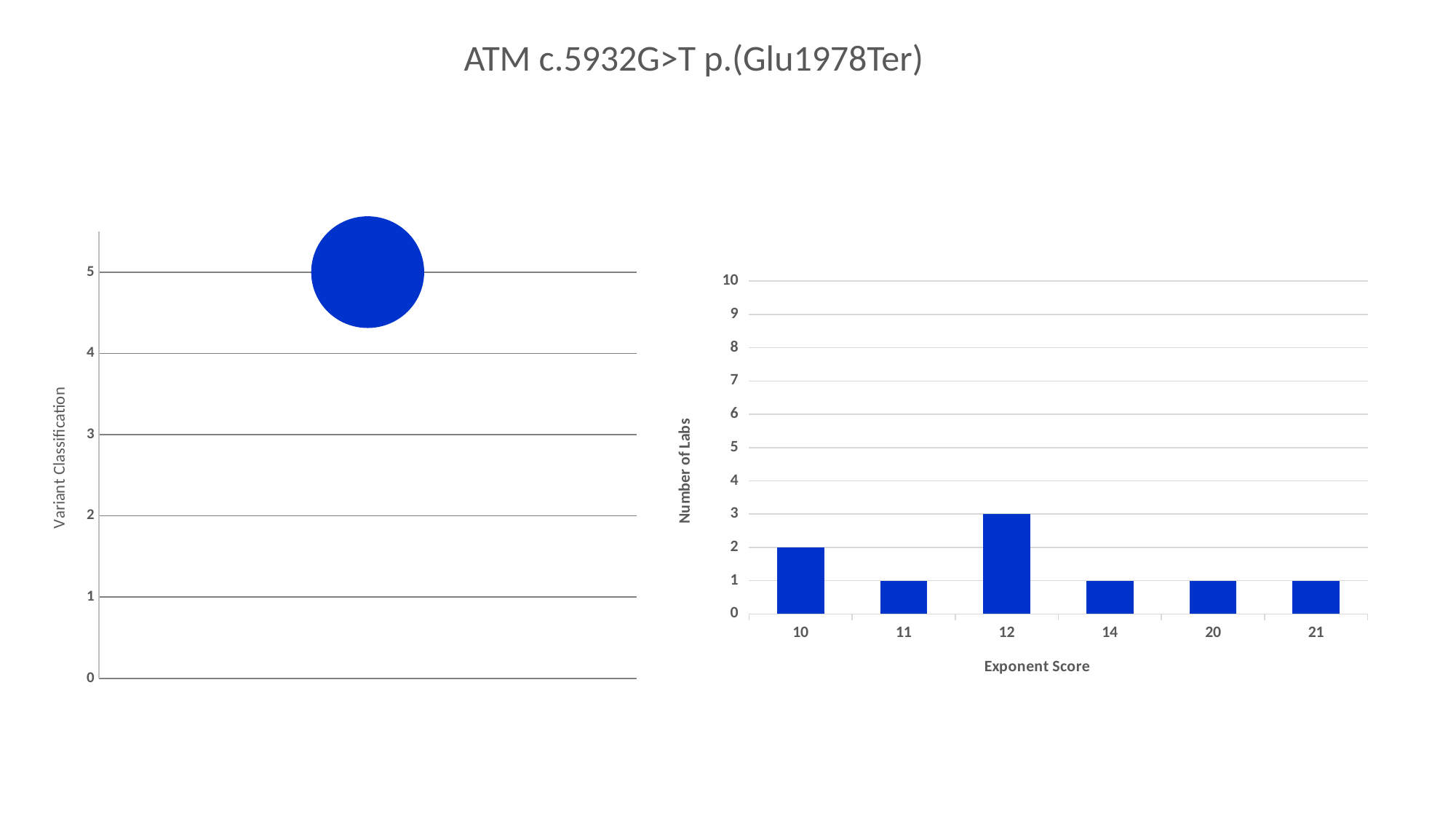
On the right chart, what is the label of the y axis? Number of Labs On the right chart, what is the difference in number of labs between Exponent Score 12 and Exponent Score 11? 2 What kind of chart is the right chart? Bar chart On the right chart, how many labs reported an Exponent Score of 10? 2 On the right chart, which Exponent Score has the highest number of labs? 12 On the left chart, is the value of the plotted point greater or less than 4? greater On the right chart, how many labs reported an Exponent Score of 21? 1 On the right chart, how many labs reported an Exponent Score of 12? 3 On the left chart, how many data points are plotted? 1 On the right chart, which has more labs: Exponent Score 10 or Exponent Score 14? Exponent Score 10 What is the title of the slide? ATM c.5932G>T p.(Glu1978Ter) On the right chart, how many Exponent Score categories are shown on the x axis? 6